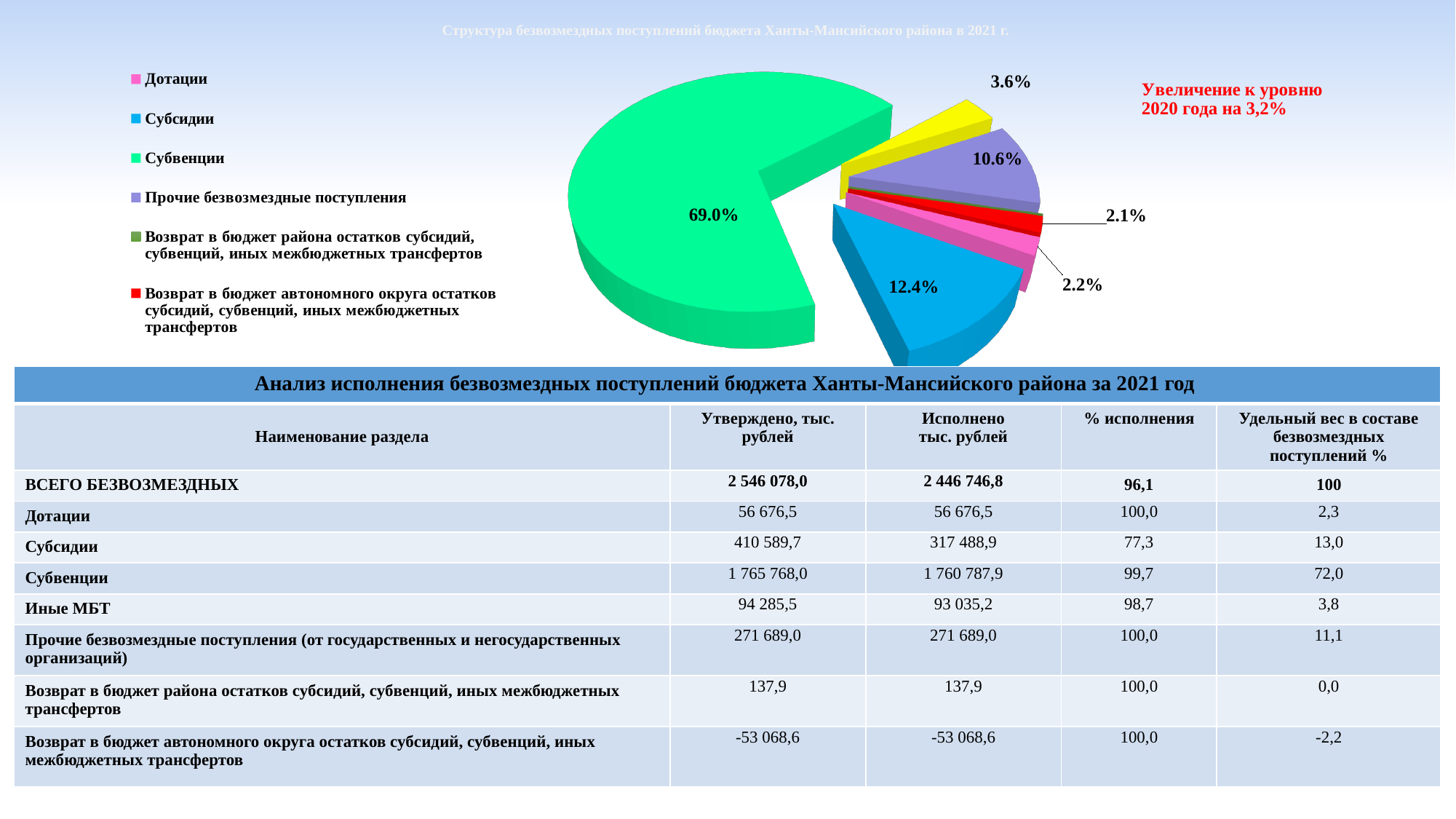
What share of the pie chart does Субвенции account for? 69.0% How many entries does the legend of the pie chart list? 6 Which category has the largest slice in the pie chart? Субвенции By how many percentage points does the Субвенции slice exceed the Субсидии slice? 56.6 percentage points What share of the pie chart does Субсидии account for? 12.4% What share of the pie chart does Прочие безвозмездные поступления account for? 10.6% Is the share for Субвенции in the pie chart greater or less than 50%? greater What colour is the Субвенции slice in the pie chart? Green What kind of chart is shown at the top of the slide? Pie chart What does the red annotation next to the pie chart say? Увеличение к уровню 2020 года на 3,2% Which slice is larger in the pie chart: Субсидии or Прочие безвозмездные поступления? Субсидии